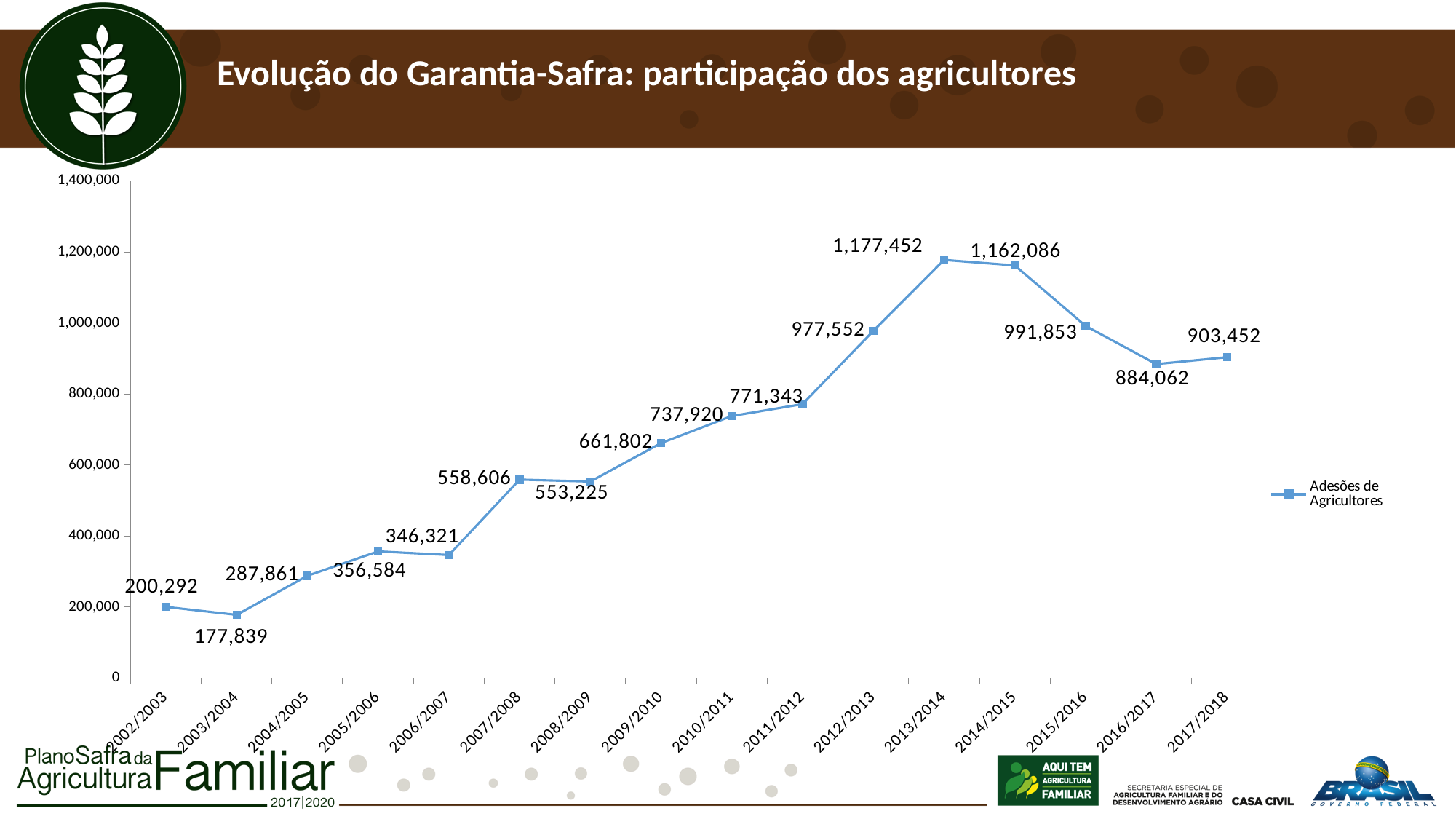
What is the value for 2003/2004? 177,839 Which period has the highest value? 2013/2014 How many series does the legend list? 1 What is the name of the series shown in the legend? Adesões de Agricultores What is the value for 2017/2018? 903,452 What is the difference between the values for 2013/2014 and 2012/2013? 199,900 Which is larger, the value for 2014/2015 or the value for 2015/2016? 2014/2015 What is the value for 2013/2014? 1,177,452 Which period has the lowest value? 2003/2004 How many periods are shown on the x axis? 16 Is the value for 2010/2011 greater or less than 600,000? greater What type of chart is shown on the slide? Line chart